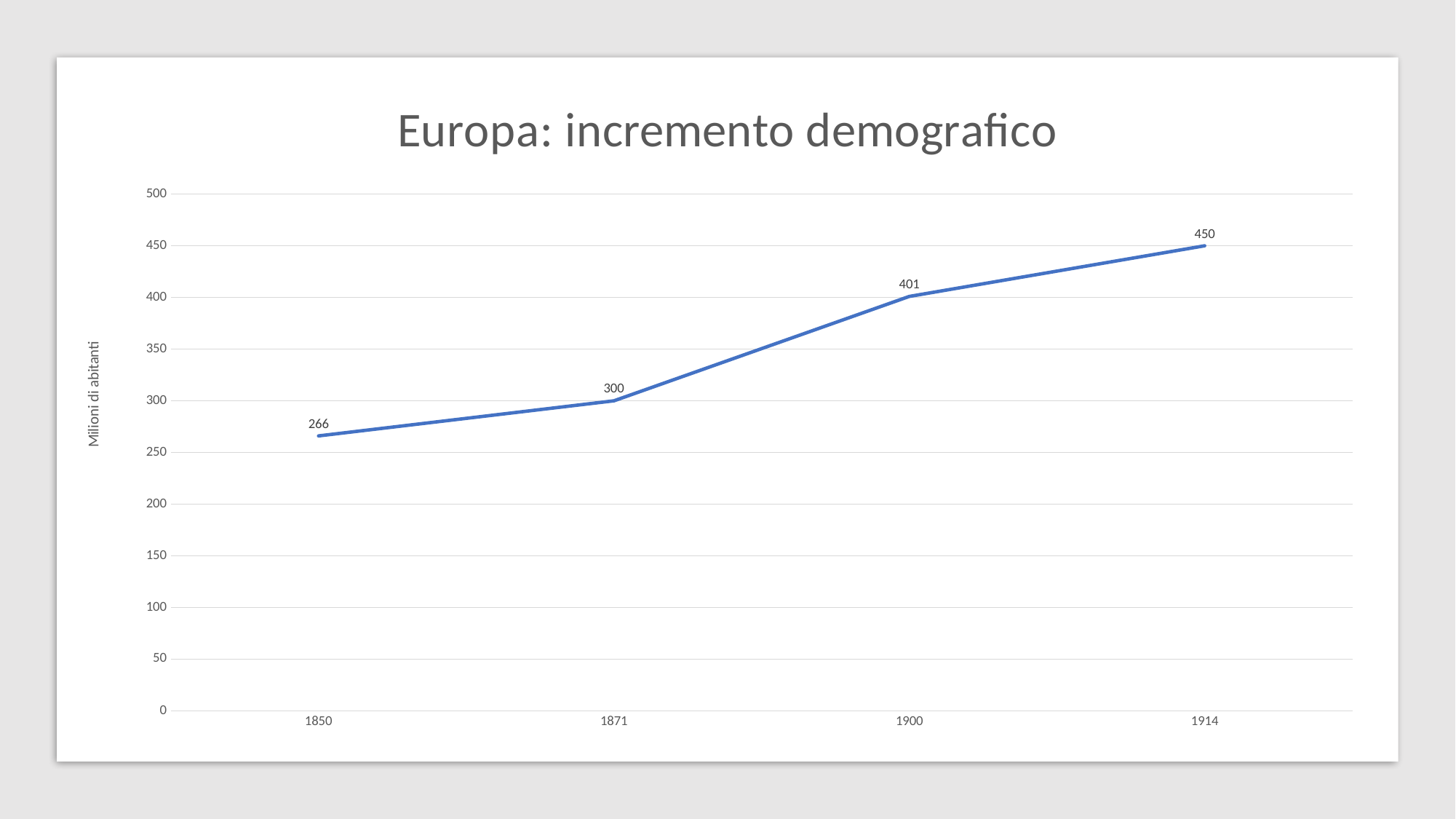
What is the value for 1914? 450 What is the value for 1850? 266 What is the value for 1871? 300 Do the values rise or fall from 1850 to 1914? rise What is the difference between the values for 1914 and 1850? 184 Which is larger, the value for 1871 or the value for 1900? 1900 How many data points are plotted on the chart? 4 What is the difference between the values for 1900 and 1871? 101 What is the value for 1900? 401 Which year has the lowest value? 1850 What kind of chart is shown on the slide? line chart Which year has the highest value? 1914